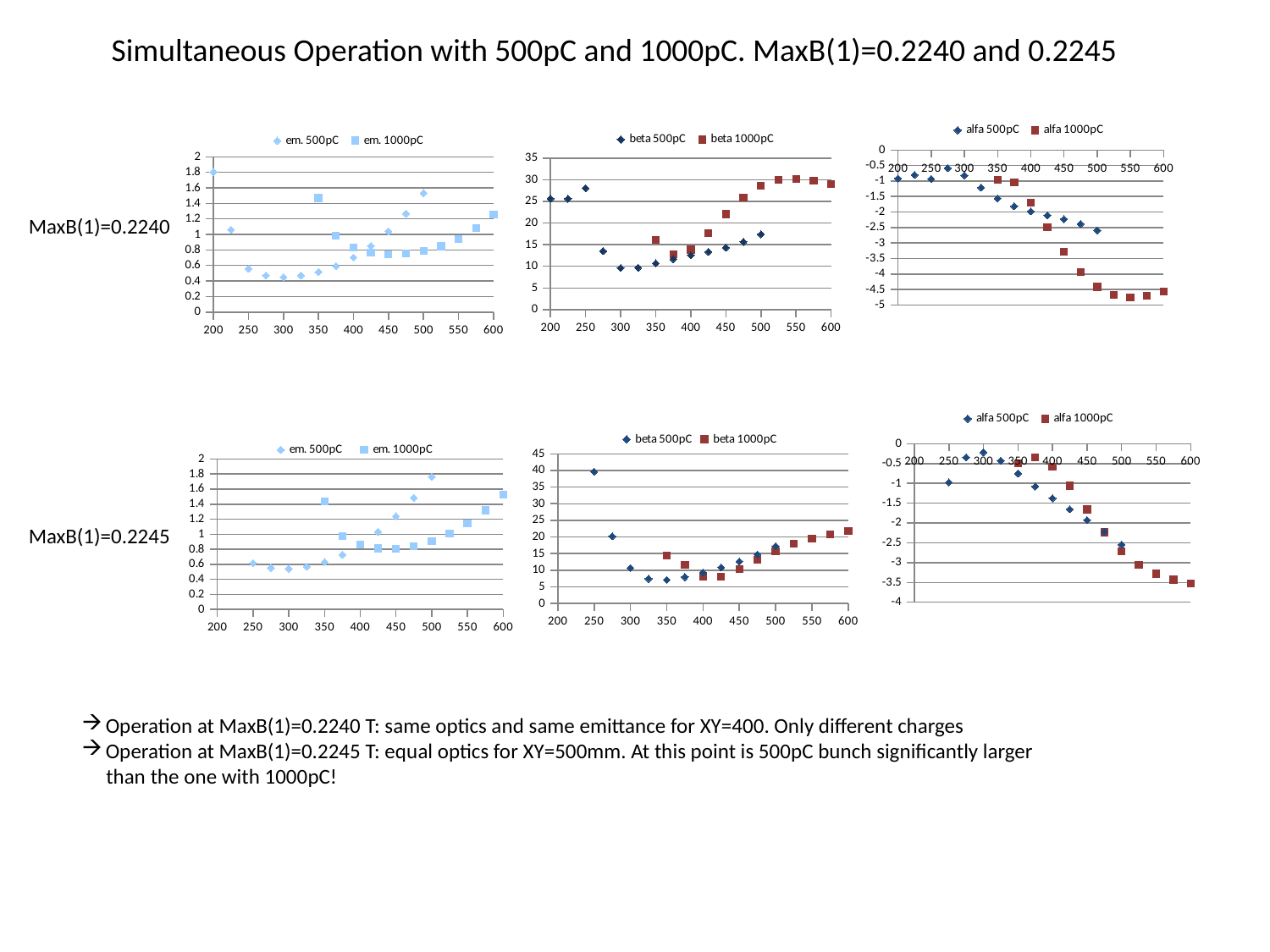
In the top-right chart (alfa at MaxB(1)=0.2240), do the alfa 500pC values rise or fall as x increases from 200 to 500? fall How many series does the legend of the top-middle chart (beta at MaxB(1)=0.2240) list? 2 What are the two legend entries of the top-right chart (MaxB(1)=0.2240)? alfa 500pC and alfa 1000pC What kind of chart is the top-left chart (em. 500pC / em. 1000pC at MaxB(1)=0.2240)? scatter chart In the bottom-right chart (alfa at MaxB(1)=0.2245), do the alfa 1000pC values rise or fall as x increases from 350 to 600? fall In the top-middle chart (beta at MaxB(1)=0.2240), is the beta 1000pC value at x=500 greater or less than 25? greater In the bottom-middle chart (beta at MaxB(1)=0.2245), at which x value does the beta 500pC series reach its highest point? 250 In the top-left chart (MaxB(1)=0.2240), at x=350 which series has the larger value, em. 500pC or em. 1000pC? em. 1000pC In the top-right chart (alfa at MaxB(1)=0.2240), is the alfa 1000pC value at x=550 greater or less than -4.5? less In the bottom-left chart (MaxB(1)=0.2245), at x=500 which series has the larger value, em. 500pC or em. 1000pC? em. 500pC In the bottom-middle chart (beta at MaxB(1)=0.2245), is the beta 500pC value at x=250 greater or less than 35? greater